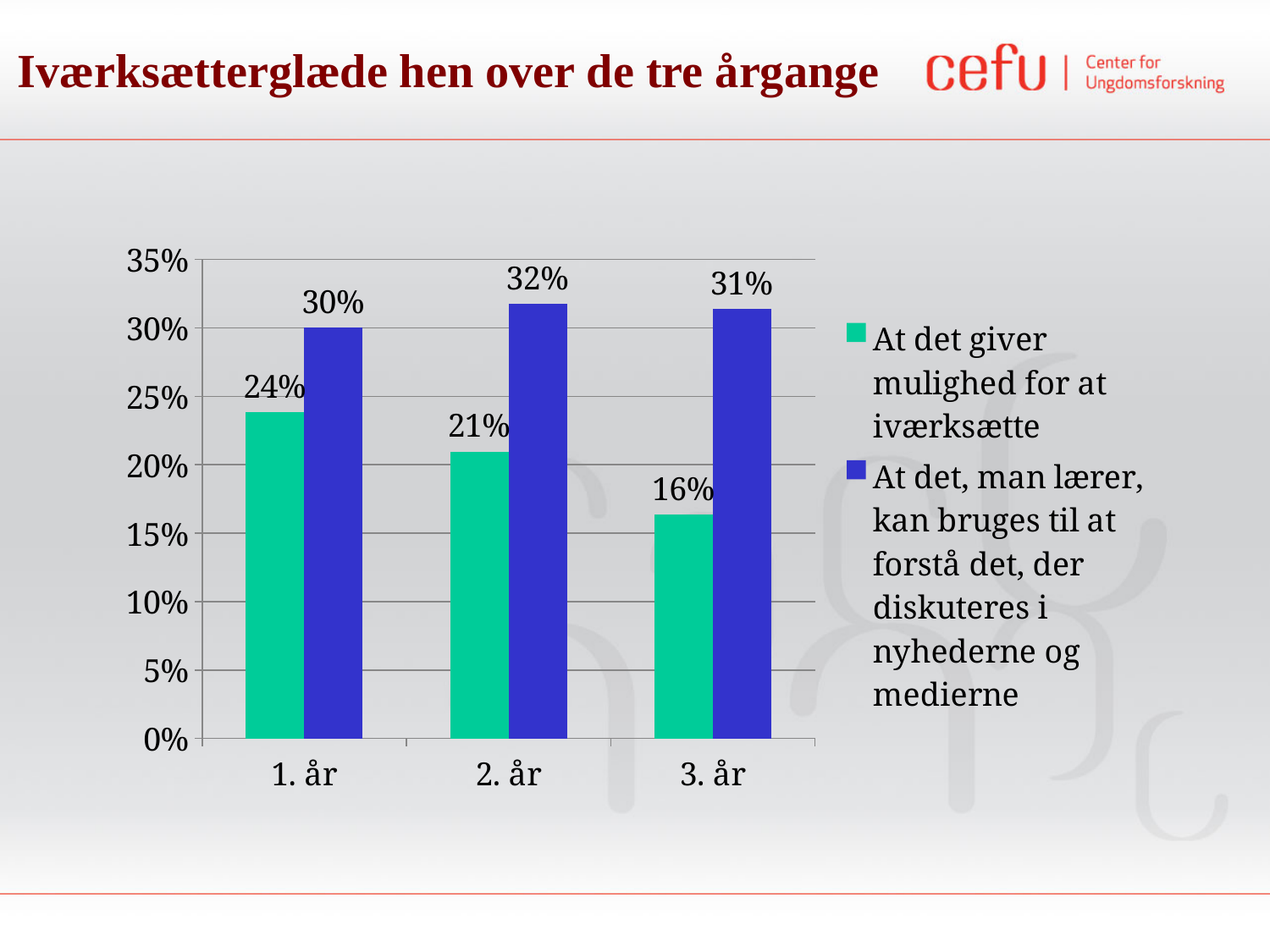
What is the value for "At det, man lærer, kan bruges til at forstå det, der diskuteres i nyhederne og medierne" in 2. år? 32% In which year is the value for "At det, man lærer, kan bruges til at forstå det, der diskuteres i nyhederne og medierne" highest? 2. år What is the value for "At det giver mulighed for at iværksætte" in 1. år? 24% What is the difference between the two series in 3. år? 15% What colour are the bars for "At det giver mulighed for at iværksætte"? Green What is the value for "At det giver mulighed for at iværksætte" in 3. år? 16% How many series does the legend list? 2 How many year categories are shown on the x axis? 3 Does the value for "At det giver mulighed for at iværksætte" rise or fall from 1. år to 3. år? Fall In which year is the value for "At det giver mulighed for at iværksætte" lowest? 3. år What kind of chart is shown on the slide? Bar chart Which series has the larger value in 1. år? At det, man lærer, kan bruges til at forstå det, der diskuteres i nyhederne og medierne